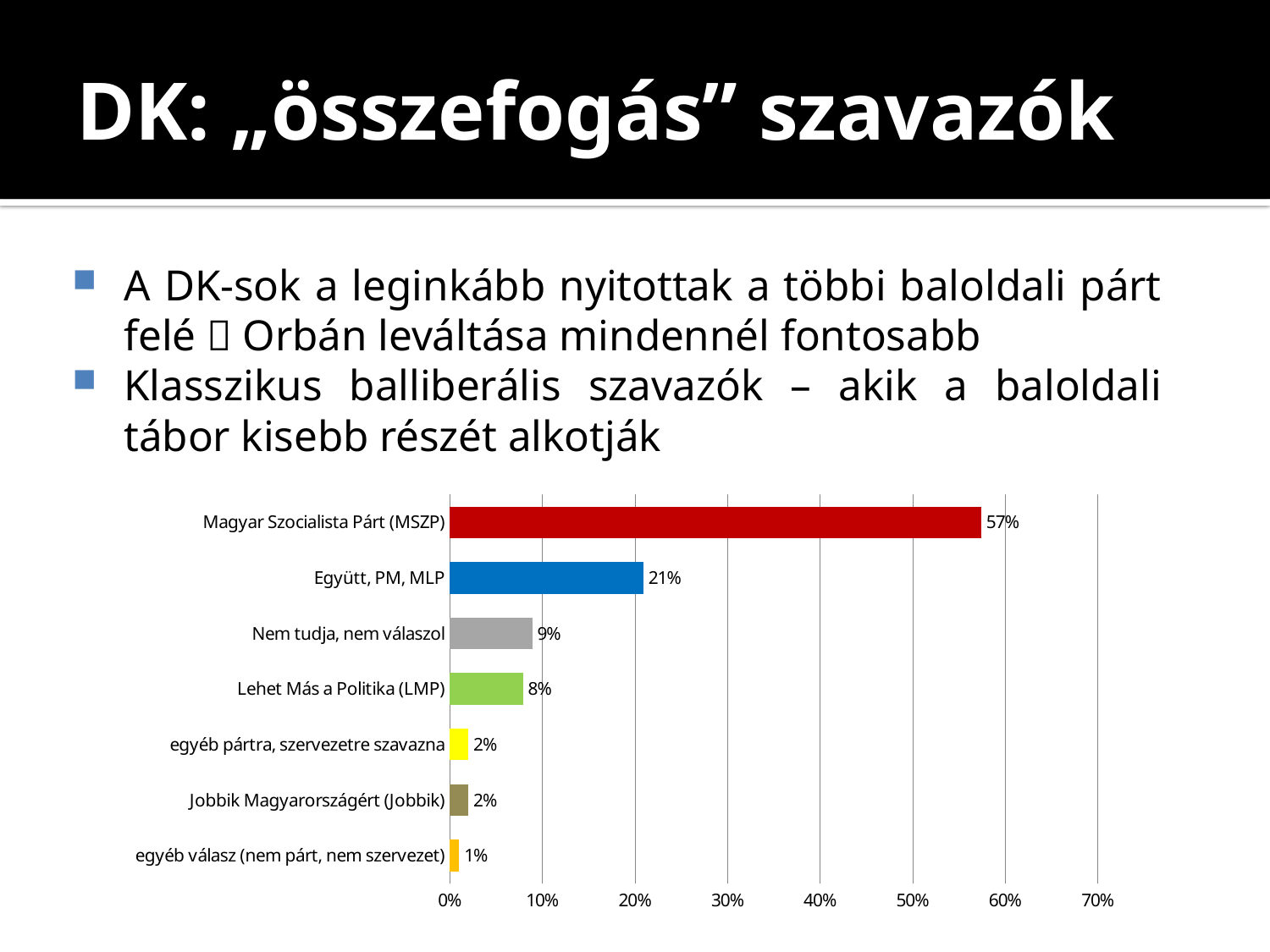
Which category has the highest value? Magyar Szocialista Párt (MSZP) What is the value for Együtt, PM, MLP? 21% What is the difference between the values for Magyar Szocialista Párt (MSZP) and Együtt, PM, MLP? 36% Which category has the lowest value? egyéb válasz (nem párt, nem szervezet) Is the value for Együtt, PM, MLP greater or less than 30%? less What colour is the bar for Magyar Szocialista Párt (MSZP)? red Which is larger, the value for Nem tudja, nem válaszol or the value for Lehet Más a Politika (LMP)? Nem tudja, nem válaszol What kind of chart is shown on the slide? bar chart What is the value for Lehet Más a Politika (LMP)? 8% How many categories are shown in the chart? 7 What is the value for Magyar Szocialista Párt (MSZP)? 57% What is the value for Nem tudja, nem válaszol? 9%